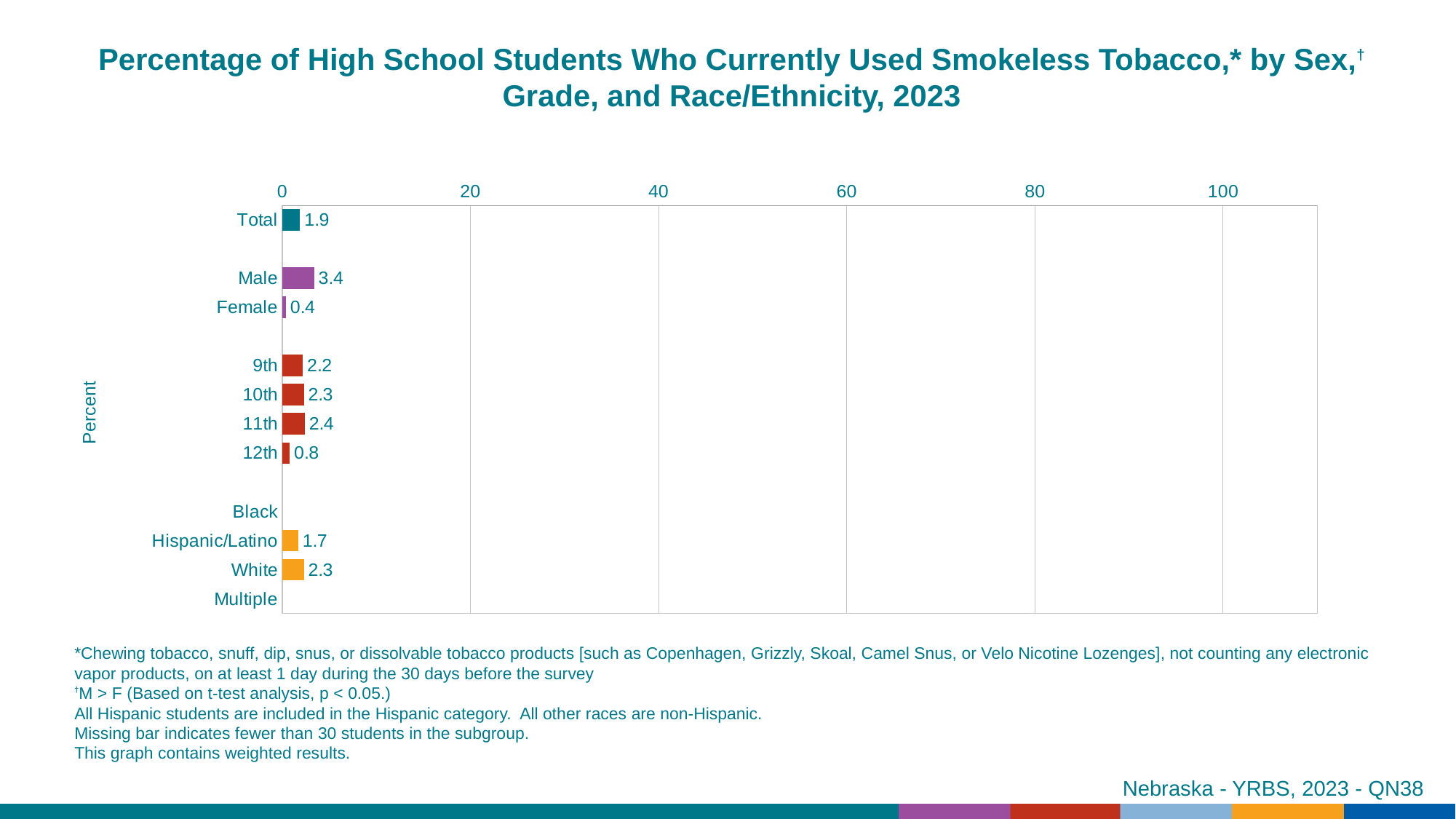
Which category has the highest value? Male What is the value for 12th grade? 0.8 Which grade has the lowest value? 12th What is the value for Male? 3.4 What kind of chart is shown? bar chart What is the difference between the Male and Female values? 3.0 What is the Total value? 1.9 Is the value for Male greater or less than 20? less Which is larger, the value for 9th grade or 11th grade? 11th Which race/ethnicity categories have no bar shown? Black and Multiple What is the value for Hispanic/Latino? 1.7 What is the value for Female? 0.4